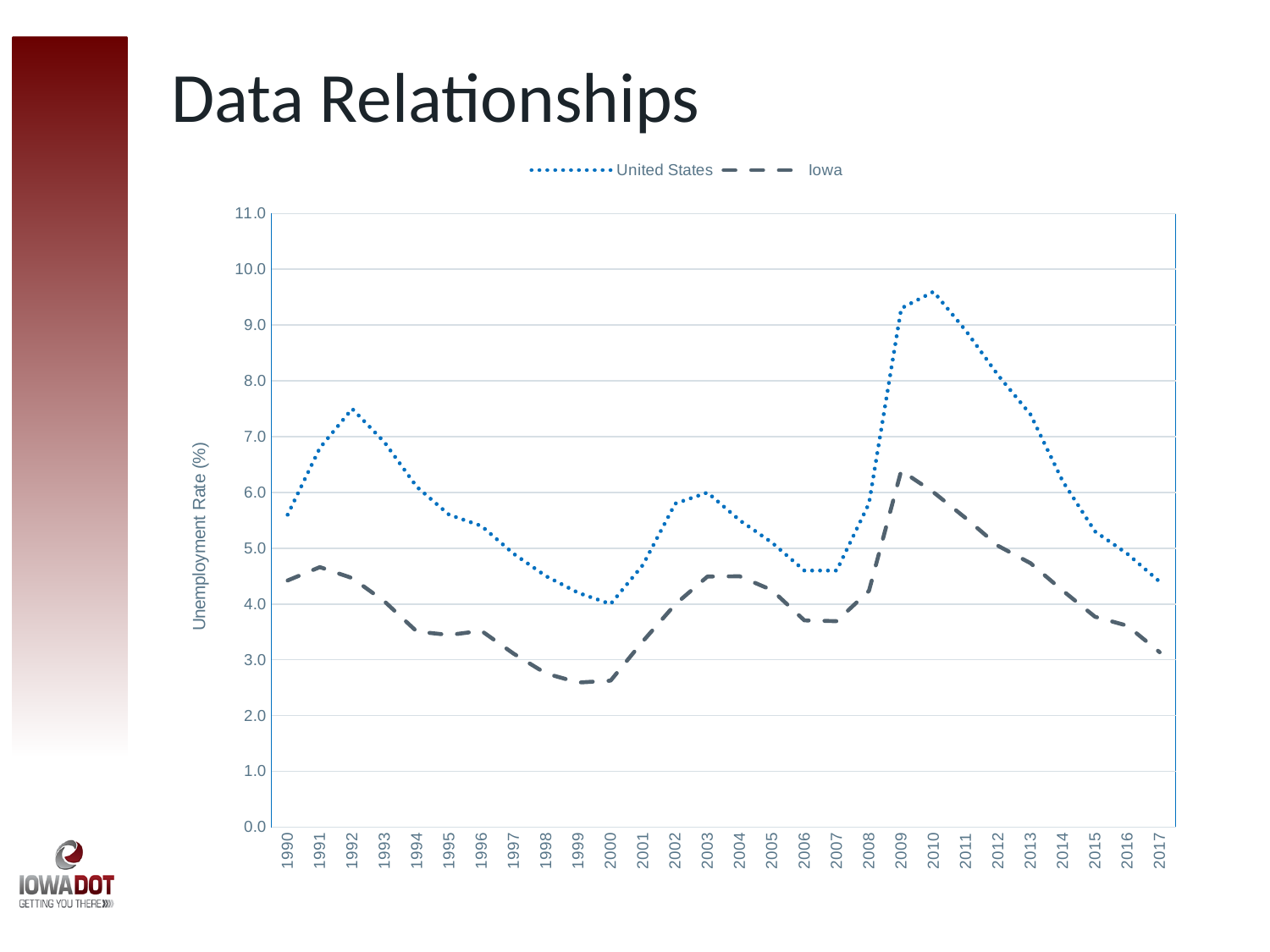
Is the Iowa value for 1999 greater or less than 3.0? less Which series has the larger value in 2010, United States or Iowa? United States How many series does the legend list? 2 In which year does the United States series reach its highest value? 2010 In which year does the Iowa series reach its lowest value? 1999 Is the United States value for 1992 greater or less than 7.0? greater Is the United States value for 2010 greater or less than 9.0? greater In which year does the Iowa series reach its highest value? 2009 What kind of chart is shown on the slide? line chart How many years are shown along the x axis? 28 Does the United States series rise or fall from 2010 to 2017? fall What is the title of the vertical axis? Unemployment Rate (%)